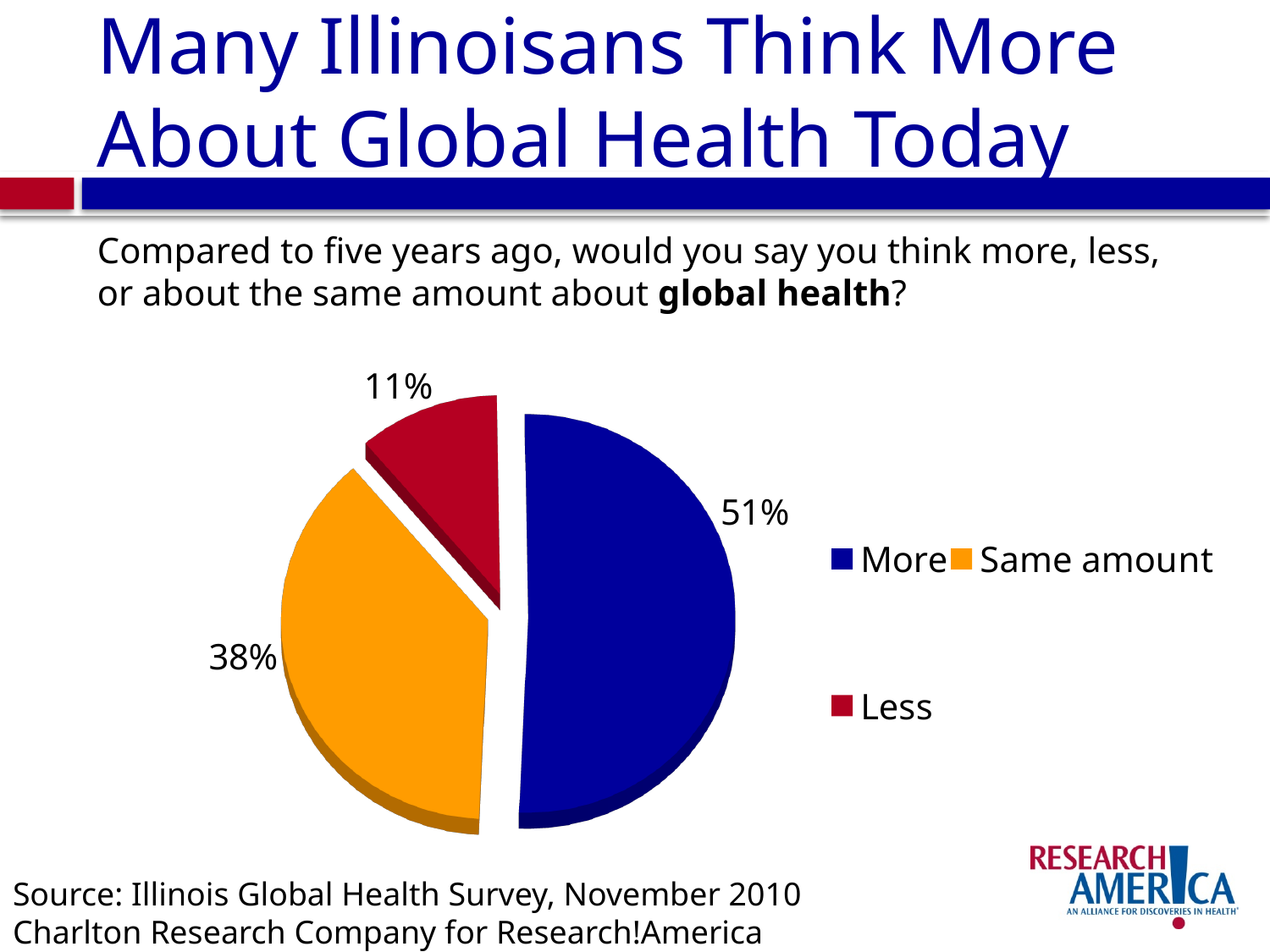
What colour is the slice representing 'Less'? Red How many entries does the legend list? 3 What is the difference in percentage points between the 'Same amount' and 'Less' slices? 27 Which response has the largest share of the pie? More What percentage of respondents said they think about the same amount about global health? 38% Which is larger, the share for 'Same amount' or the share for 'Less'? Same amount How many slices does the pie chart have? 3 What percentage of respondents said they think less about global health? 11% Which response has the smallest share of the pie? Less What kind of chart is shown on the slide? Pie chart What is the difference in percentage points between the 'More' and 'Same amount' slices? 13 What percentage of respondents said they think more about global health compared to five years ago? 51%